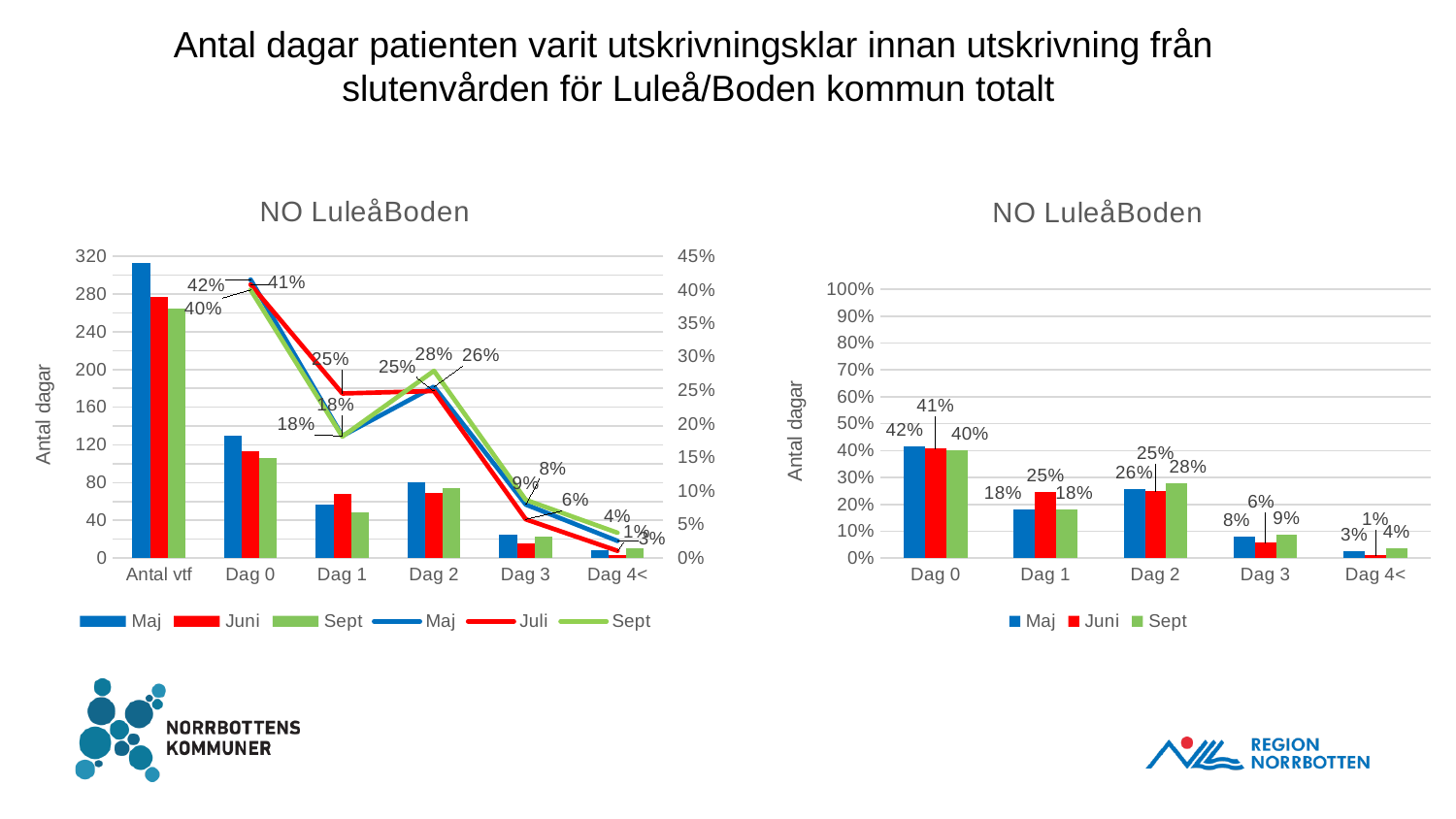
In the left chart, is the Maj bar for Antal vtf greater or less than 280? greater In the right chart, what is the value for Juni at Dag 1? 25% How many categories are shown on the x axis of the right chart? 5 In the right chart, which category has the highest value for the Maj series? Dag 0 In the right chart, what is the value for Maj at Dag 0? 42% In the left chart, is the Maj bar for Dag 0 greater or less than 120? greater In the right chart, what is the value for Sept at Dag 2? 28% In the right chart, what is the difference between the Juni values at Dag 0 and Dag 4<? 40% In the right chart, which is larger at Dag 3: the Maj value or the Sept value? Sept How many series does the legend of the left chart list? 6 In the right chart, which category has the lowest value for the Juni series? Dag 4< What kind of chart is the right chart? Bar chart